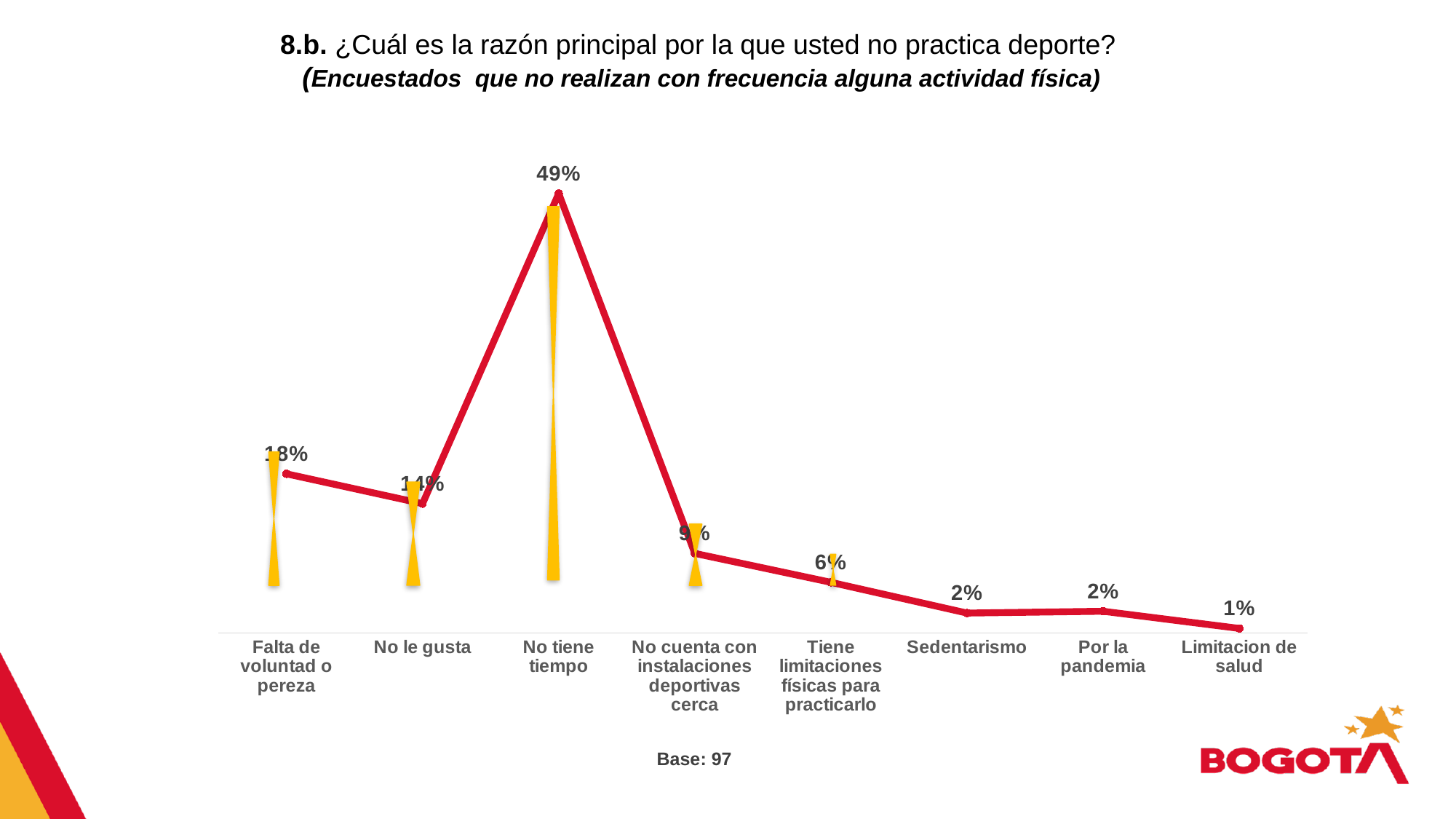
What is the base (number of respondents) stated below the chart? 97 From "No tiene tiempo" to "Limitacion de salud", do the values rise or fall along the x axis? Fall What is the value shown for "No le gusta"? 14% What is the value shown for "Limitacion de salud"? 1% What is the difference in percentage points between "No tiene tiempo" and "Falta de voluntad o pereza"? 31 percentage points Which reason has the lowest percentage? Limitacion de salud Which reason has the highest percentage? No tiene tiempo How many reasons (categories) are shown on the x axis? 8 What percentage of respondents gave "No tiene tiempo" as the main reason for not practising sport? 49% What is the value shown for "Falta de voluntad o pereza"? 18% What is the value shown for "Tiene limitaciones físicas para practicarlo"? 6% Which is larger, the value for "No le gusta" or the value for "No cuenta con instalaciones deportivas cerca"? No le gusta